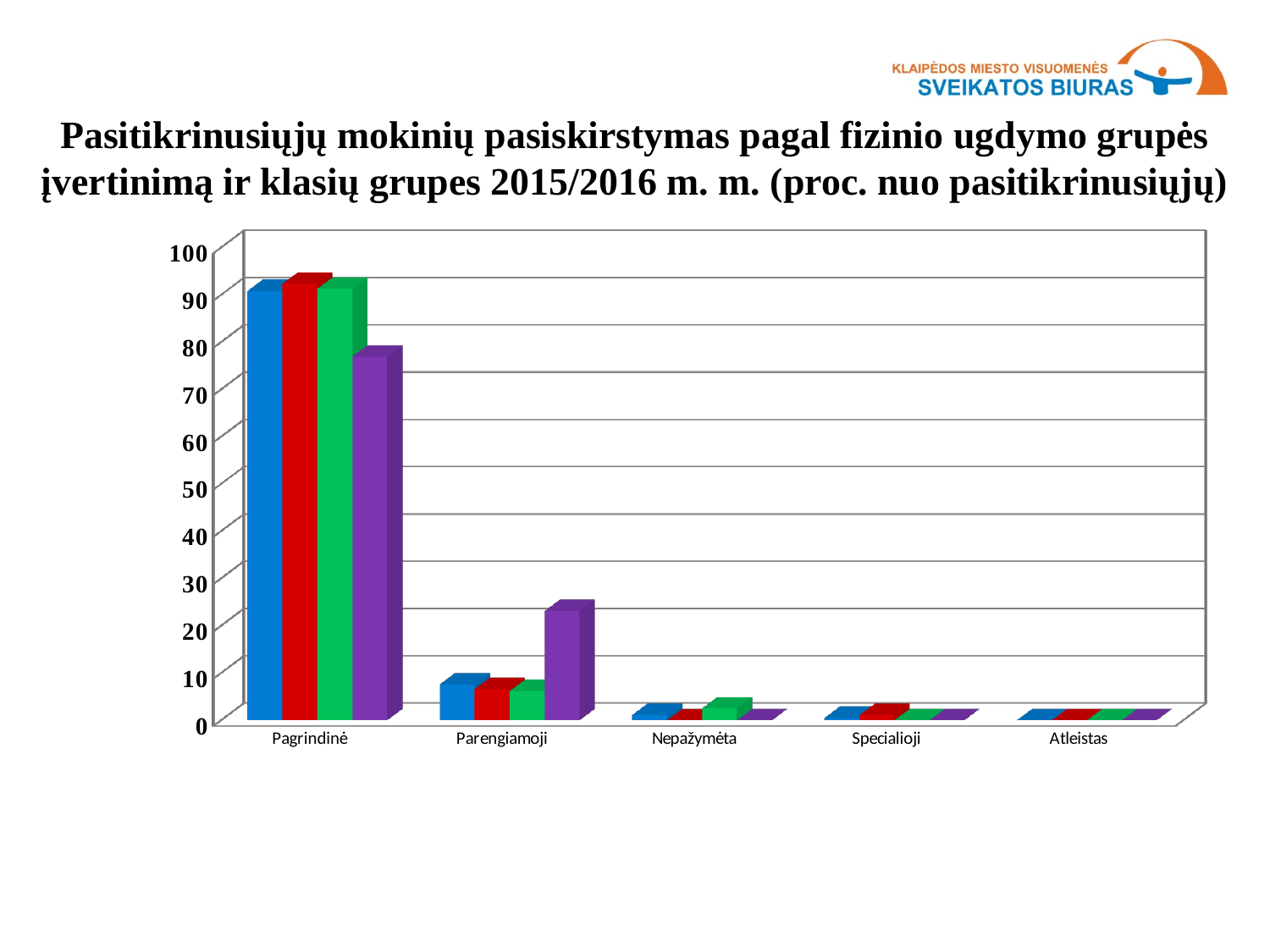
How many categories are shown on the x axis of the chart? 5 Is the value of the blue bar for Parengiamoji greater or less than 20? less Is the value of the purple bar for Parengiamoji greater or less than 10? greater Do the values generally rise or fall moving from Pagrindinė to Atleistas along the x axis? fall How many bars are plotted for each category in the chart? 4 What kind of chart is shown on the slide? bar chart Is the value of the blue bar for Pagrindinė greater or less than 80? greater Which category has the highest values in the chart? Pagrindinė What school year is named in the chart title? 2015/2016 m. m. Within the Parengiamoji category, which bar is taller: the blue bar or the purple bar? the purple bar Which is larger: the purple bar for Pagrindinė or the purple bar for Parengiamoji? Pagrindinė